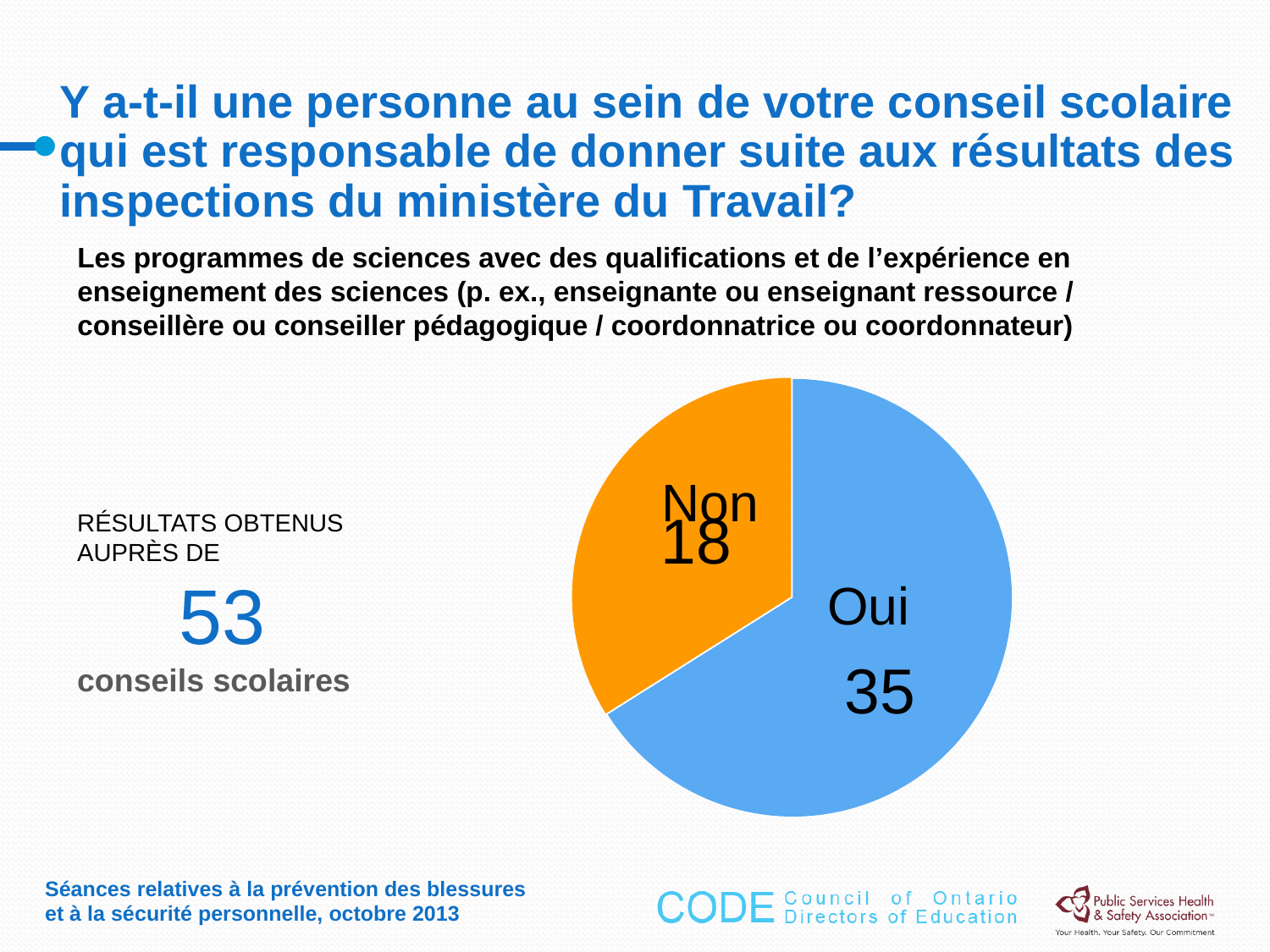
What is the value for Oui in the pie chart? 35 What colour is the Non slice of the pie chart? Orange Which slice of the pie chart is the largest? Oui How many slices does the pie chart have? 2 What is the value for Non in the pie chart? 18 What is the difference between the Oui and Non values in the pie chart? 17 What colour is the Oui slice of the pie chart? Blue Which is larger in the pie chart, Oui or Non? Oui What is the total of the Oui and Non values in the pie chart? 53 Which slice of the pie chart is the smallest? Non What kind of chart is shown on the slide? Pie chart